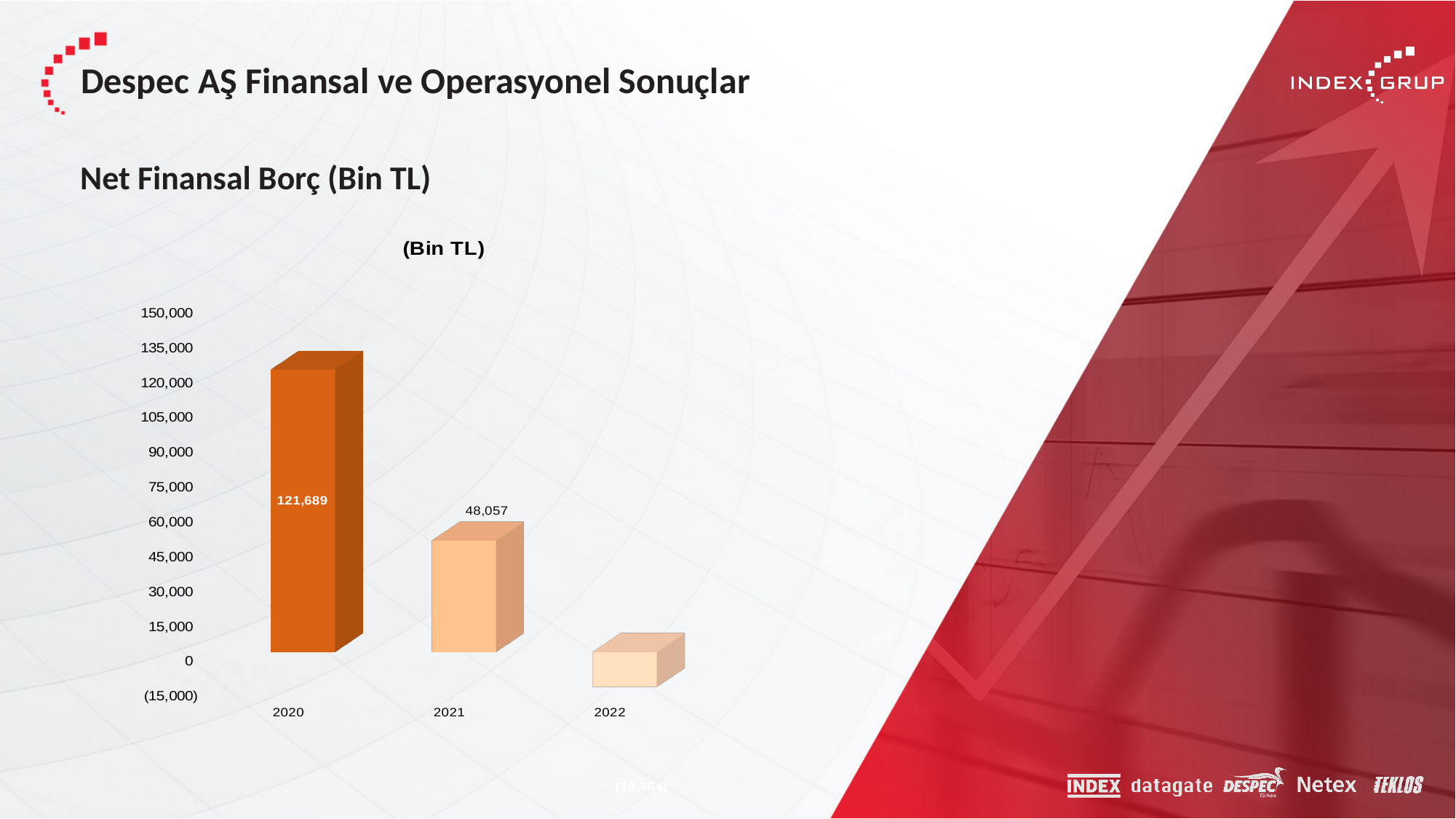
Which is larger, the value for 2020 or the value for 2021? 2020 Is the value for 2021 greater or less than 60,000? less Is the value for 2020 greater or less than 105,000? greater What kind of chart is shown on the slide? bar chart How many years are shown on the x axis of the chart? 3 What is the value for 2020 in the chart? 121,689 Which year has the lowest value in the chart? 2022 What is the difference between the values for 2020 and 2021? 73,632 Do the values rise or fall from 2020 to 2022? fall Which year has the highest value in the chart? 2020 Is the value for 2022 greater or less than 0? less What is the value for 2021 in the chart? 48,057